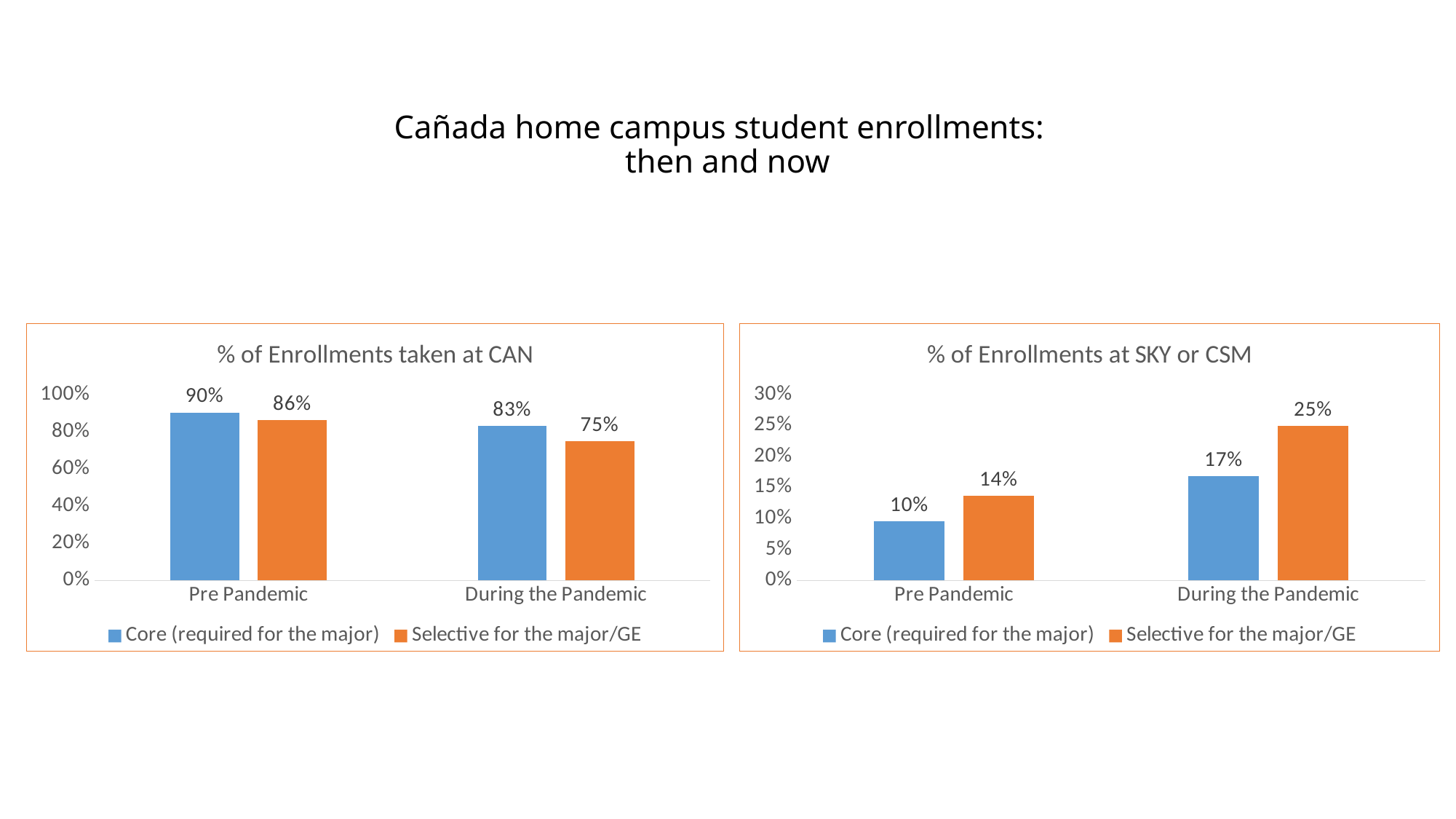
In the '% of Enrollments at SKY or CSM' chart, which bar has the lowest value? Core (required for the major), Pre Pandemic In the '% of Enrollments at SKY or CSM' chart, what is the value for Core (required for the major) in the Pre Pandemic period? 10% In the '% of Enrollments taken at CAN' chart, what is the difference between the Core values for Pre Pandemic and During the Pandemic? 7% How many series does the legend of the '% of Enrollments at SKY or CSM' chart list? 2 In the '% of Enrollments taken at CAN' chart, do the Selective for the major/GE values rise or fall from Pre Pandemic to During the Pandemic? fall In the '% of Enrollments at SKY or CSM' chart, which is larger during the Pandemic: Core (required for the major) or Selective for the major/GE? Selective for the major/GE What kind of chart is the '% of Enrollments taken at CAN' chart? bar chart In the '% of Enrollments taken at CAN' chart, which bar has the highest value? Core (required for the major), Pre Pandemic In the '% of Enrollments taken at CAN' chart, what is the value for Selective for the major/GE during the Pandemic? 75% In the '% of Enrollments taken at CAN' chart, what is the value for Core (required for the major) in the Pre Pandemic period? 90% In the '% of Enrollments at SKY or CSM' chart, what is the value for Selective for the major/GE during the Pandemic? 25% In the '% of Enrollments at SKY or CSM' chart, what is the difference between the Selective for the major/GE values for During the Pandemic and Pre Pandemic? 11%